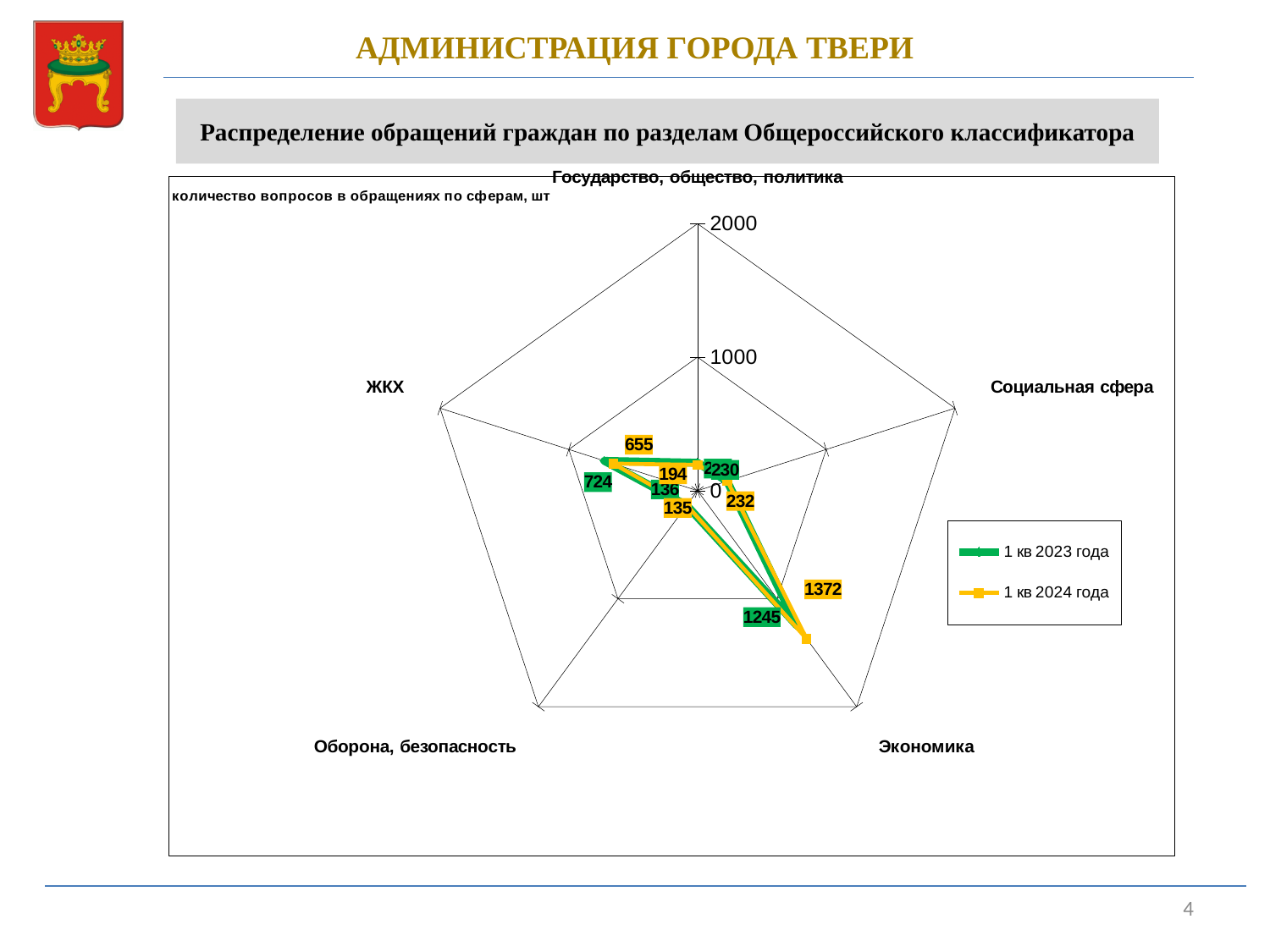
Is the value for Экономика in 1 кв 2024 года greater or less than 1000? greater How many categories (axes) does the radar chart have? 5 Which category has the highest value in 1 кв 2024 года? Экономика Which is larger for ЖКХ: the value for 1 кв 2023 года or 1 кв 2024 года? 1 кв 2023 года How many series does the legend list? 2 What is the value for ЖКХ in 1 кв 2023 года? 724 What is the difference between the Экономика values for 1 кв 2024 года and 1 кв 2023 года? 127 What are the two series named in the legend? 1 кв 2023 года and 1 кв 2024 года What is the value for Экономика in 1 кв 2023 года? 1245 What kind of chart is shown on the slide? Radar chart What is the value for ЖКХ in 1 кв 2024 года? 655 What is the value for Экономика in 1 кв 2024 года? 1372